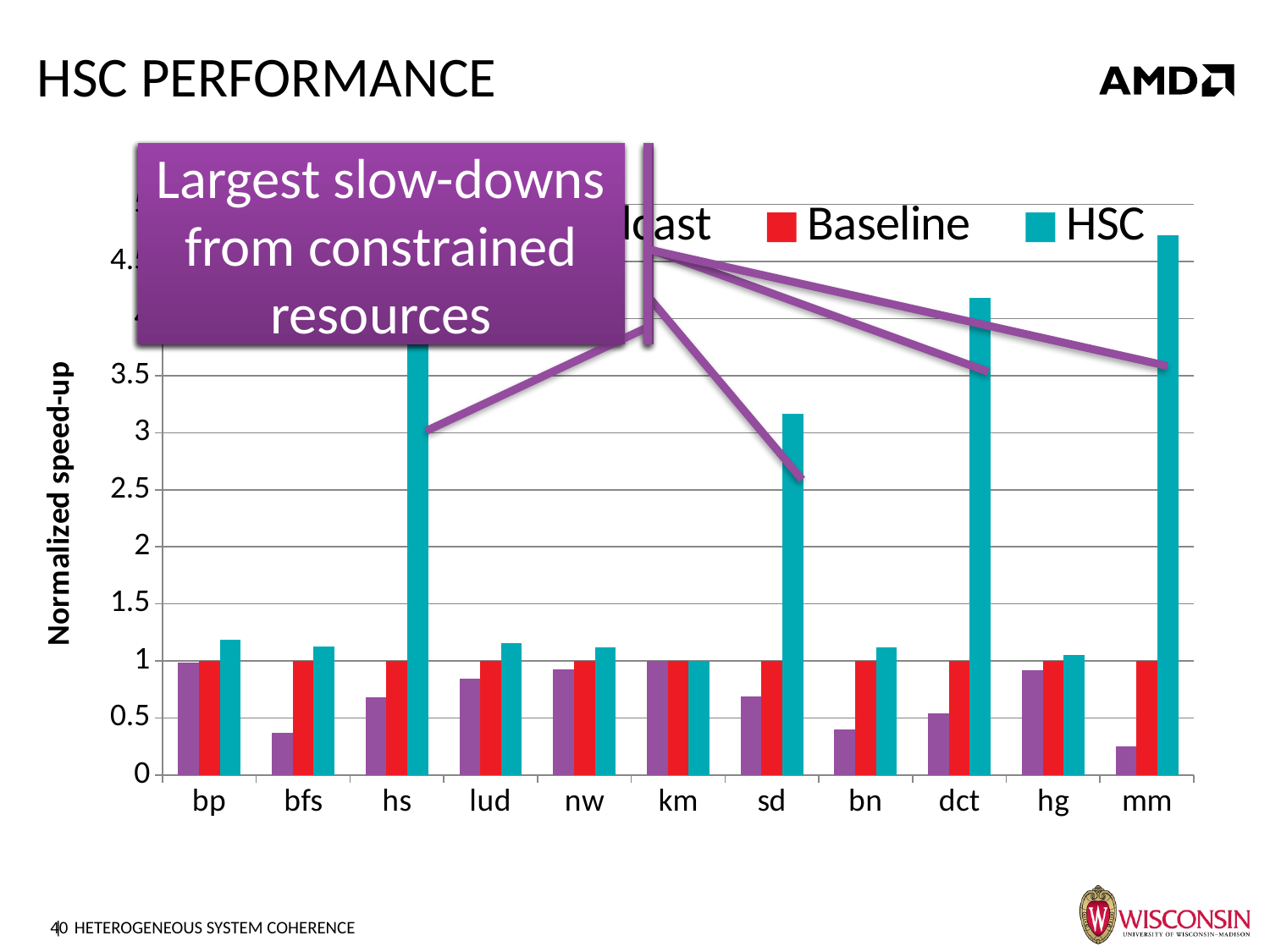
Is the HSC value for bp greater or less than 1? greater What is the label of the y axis? Normalized speed-up Is the HSC value for sd greater or less than 3? greater Is the HSC value for mm greater or less than 4.5? greater How many series does the legend list? 3 Which has the larger HSC value, mm or dct? mm Which category has the lowest value for the purple (first) series? mm Which has the larger HSC value, dct or sd? dct How many categories are shown on the x axis? 11 What is the Baseline value for km? 1 What kind of chart is shown on the slide? bar chart